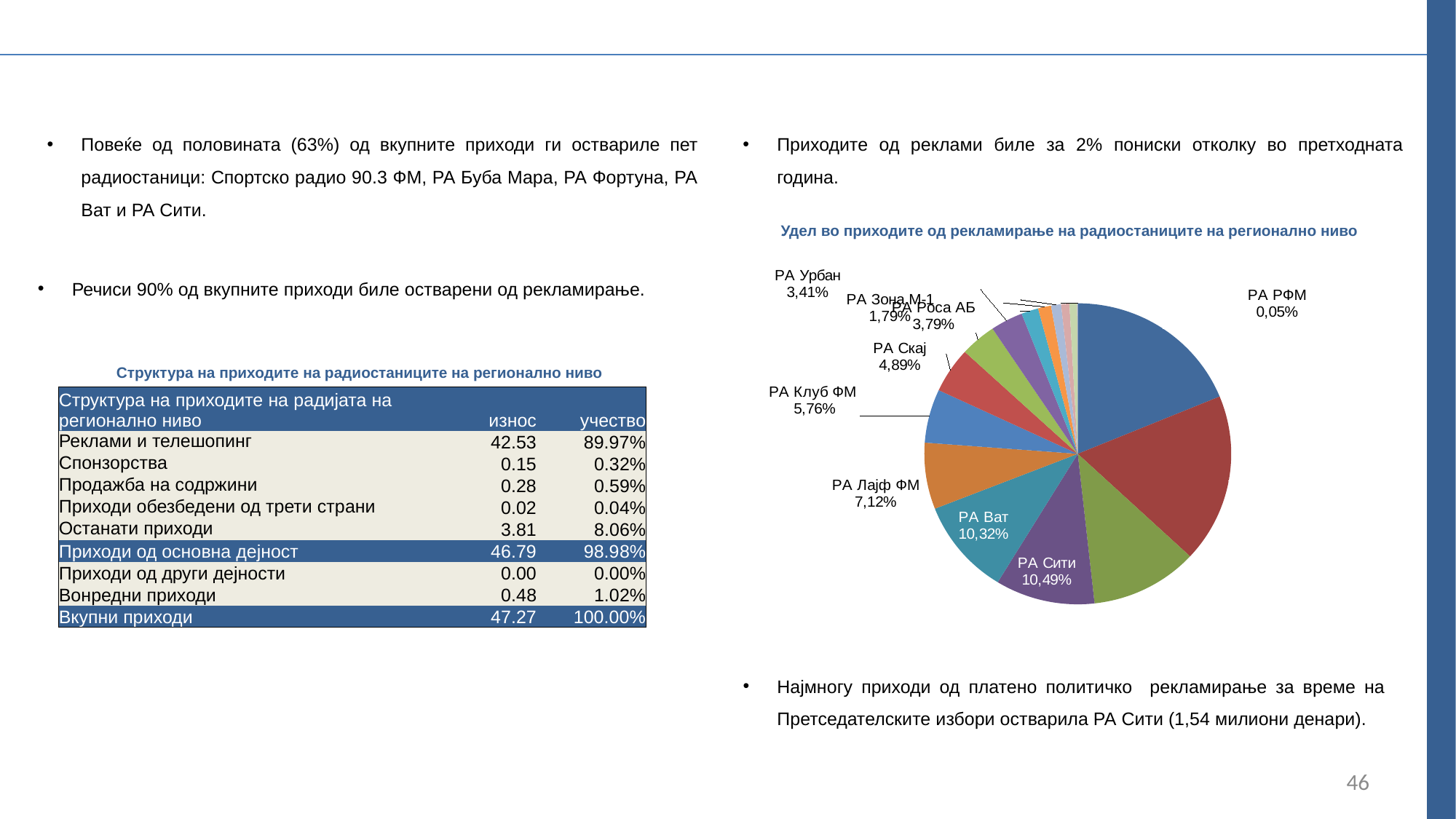
What is the title of the pie chart? Удел во приходите од рекламирање на радиостаниците на регионално ниво What is the difference in share between РА Сити and РА Ват in the pie chart? 0,17% What share does РА Ват have in the pie chart? 10,32% What share does РА РФМ have in the pie chart? 0,05% Which has the larger share in the pie chart, РА Лајф ФМ or РА Клуб ФМ? РА Лајф ФМ What share does РА Скај have in the pie chart? 4,89% What share of advertising revenue does РА Сити have in the pie chart? 10,49% What share does РА Урбан have in the pie chart? 3,41% What share does РА Клуб ФМ have in the pie chart? 5,76% What is the difference in share between РА Лајф ФМ and РА Клуб ФМ in the pie chart? 1,36% What share does РА Лајф ФМ have in the pie chart? 7,12% What kind of chart is shown on the slide? pie chart